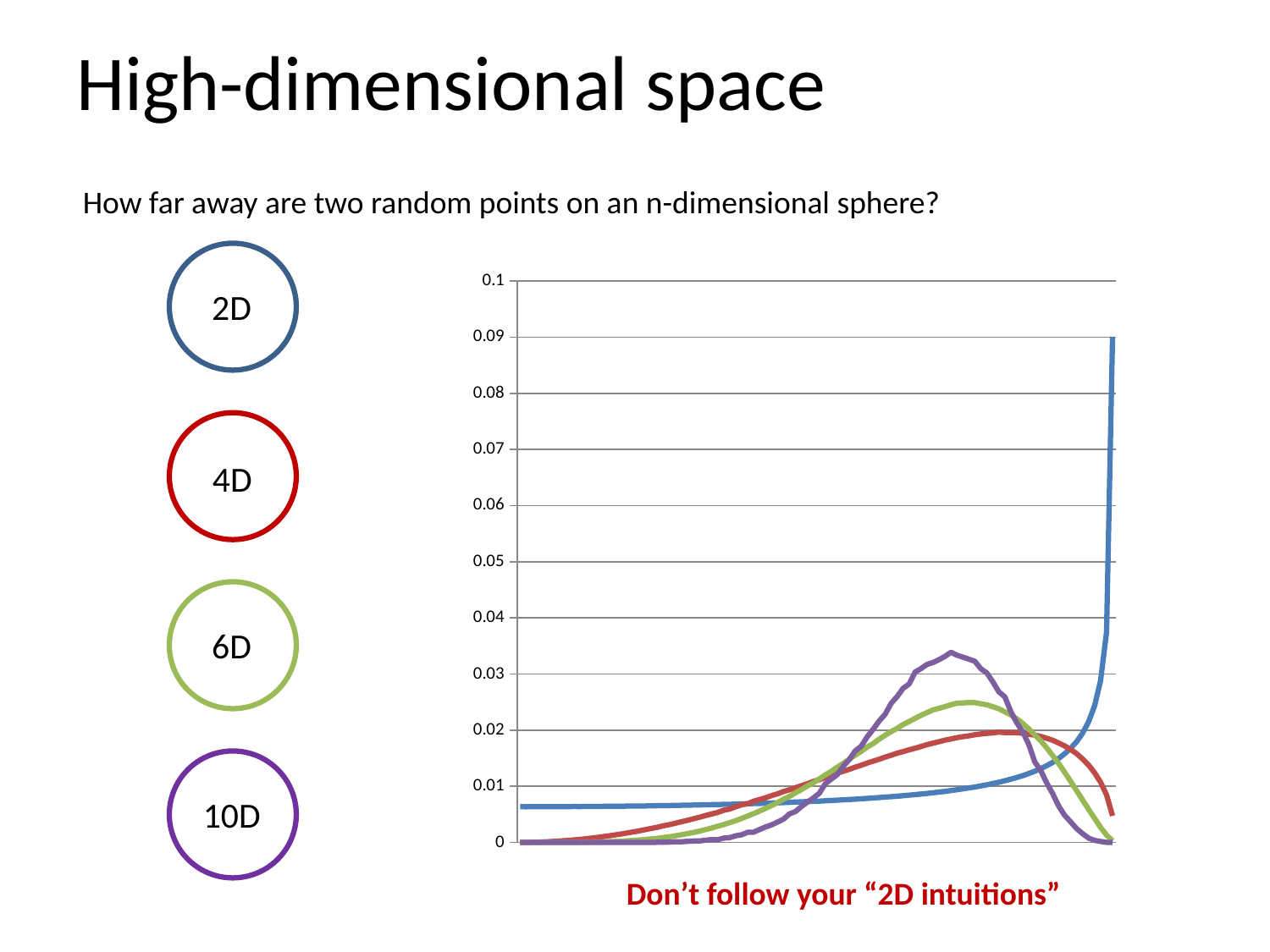
Is the peak of the red (4D) curve greater or less than 0.03? less Is the peak of the green (6D) curve greater or less than 0.02? greater Does the blue (2D) curve rise or fall as it moves to the right along the x axis? rise Which curve has the higher peak, the purple (10D) curve or the green (6D) curve? purple (10D) Which series reaches the highest value on the chart? 2D Is the highest value of the blue (2D) curve greater or less than 0.08? greater What kind of chart is shown on the slide? line chart How many curves (series) are plotted on the chart? 4 What is the highest value shown on the y axis? 0.1 Which colour represents the 10D case on the chart? purple